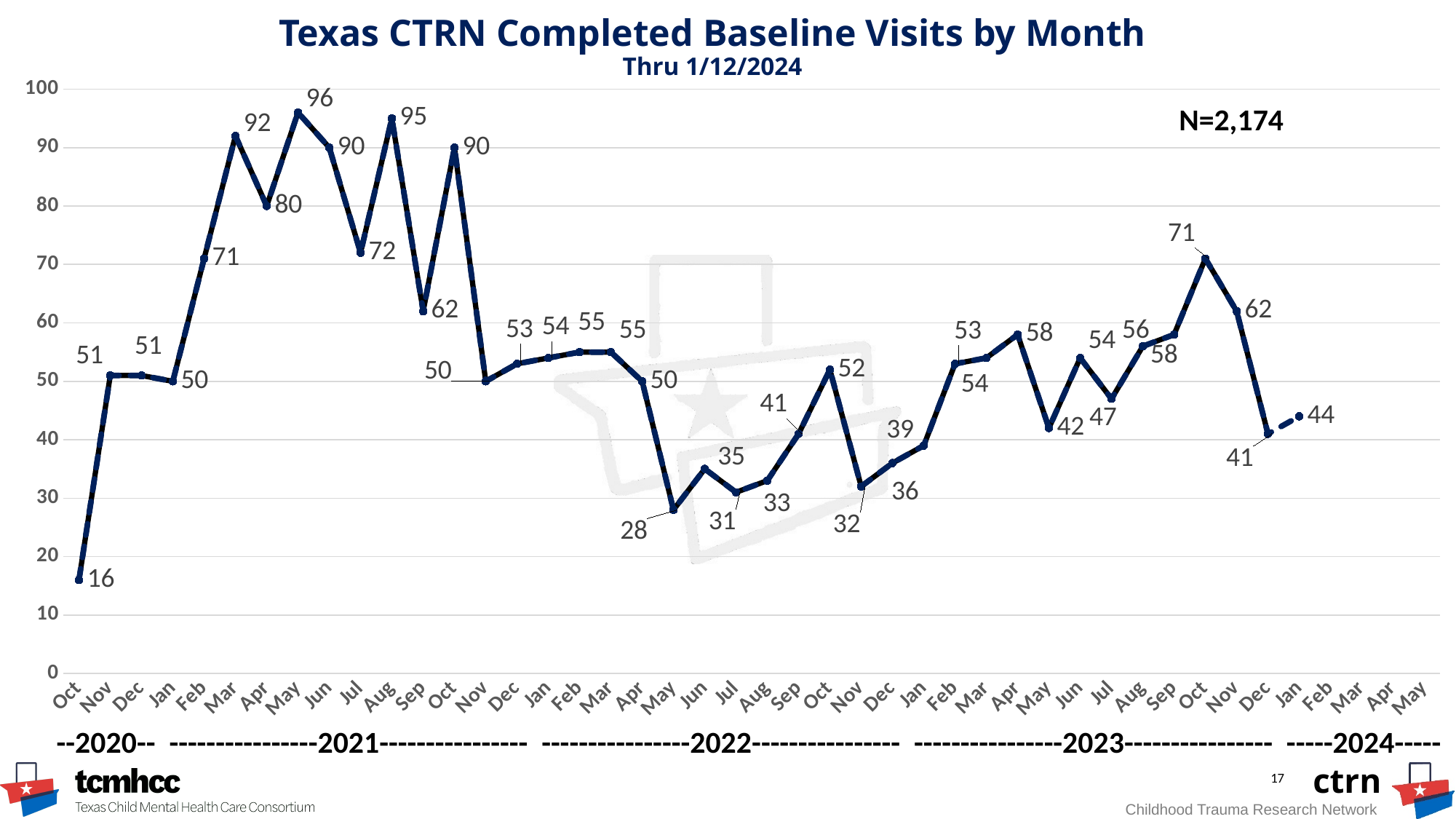
What is the value for Oct 2020? 16 Do the values rise or fall from May 2022 to Jun 2022? rise Which month has the highest number of completed baseline visits? May 2021 What type of chart is shown on the slide? line chart Which month has the lowest number of completed baseline visits? Oct 2020 What is the value for May 2022? 28 Which is larger, the value for Aug 2021 or the value for Oct 2021? Aug 2021 Is the value for Mar 2021 greater or less than 90? greater What is the value for May 2021? 96 What is the difference between the values for Oct 2023 and Dec 2023? 30 What is the value for Jan 2024? 44 What total N is shown on the chart? N=2,174